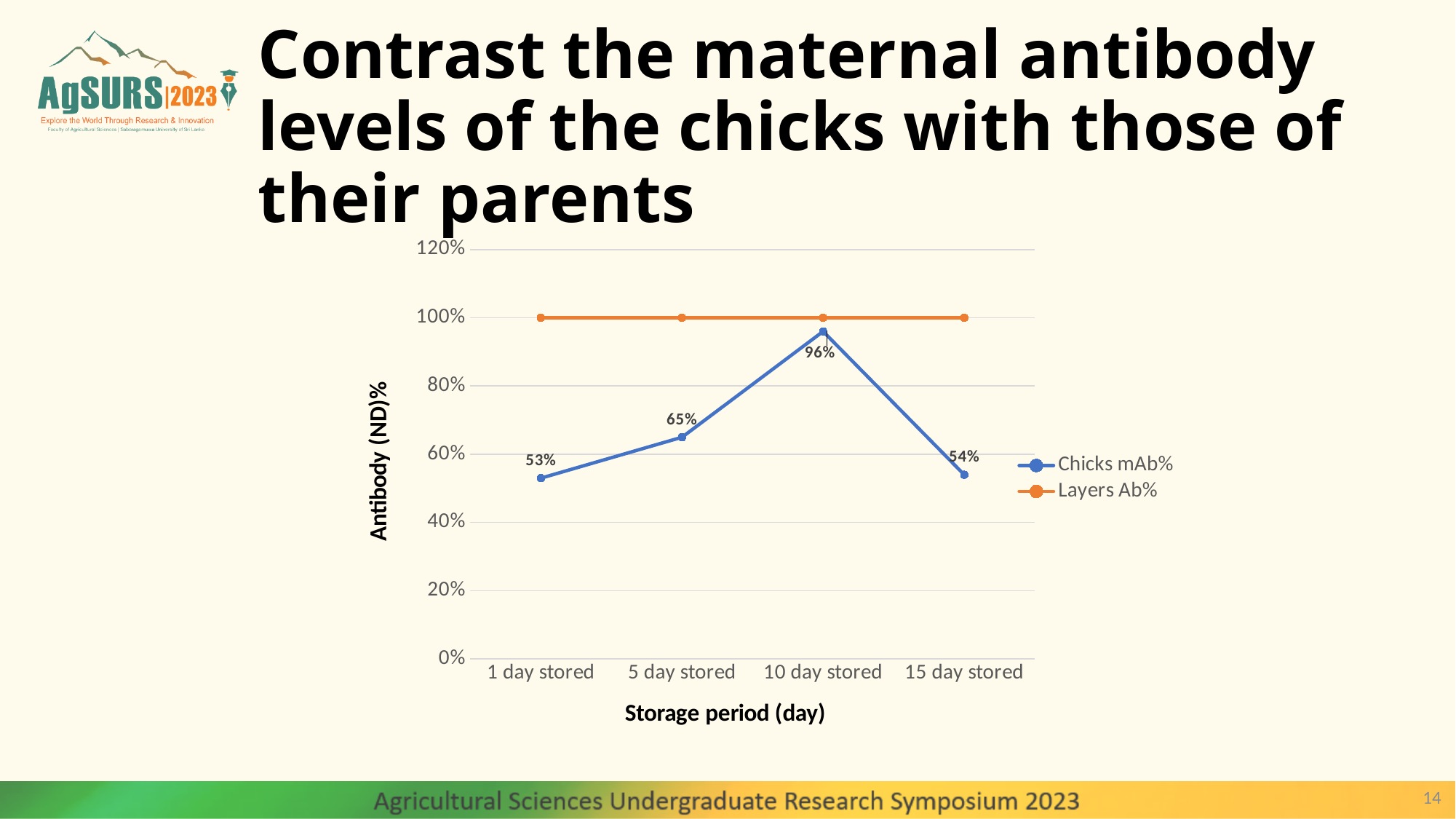
At which storage period is the Chicks mAb% highest? 10 day stored What is the Chicks mAb% value for 15 day stored? 54% Is the Chicks mAb% value for 5 day stored greater or less than 60%? greater What is the Chicks mAb% value for 1 day stored? 53% Which is larger, the Chicks mAb% at 5 day stored or at 15 day stored? 5 day stored How many series does the legend list? 2 What is the difference between the Chicks mAb% at 10 day stored and at 5 day stored? 31% What is the Chicks mAb% value for 10 day stored? 96% What is the label of the y axis? Antibody (ND)% What type of chart is shown on the slide? line chart How many storage period categories are shown on the x axis? 4 At which storage period is the Chicks mAb% lowest? 1 day stored